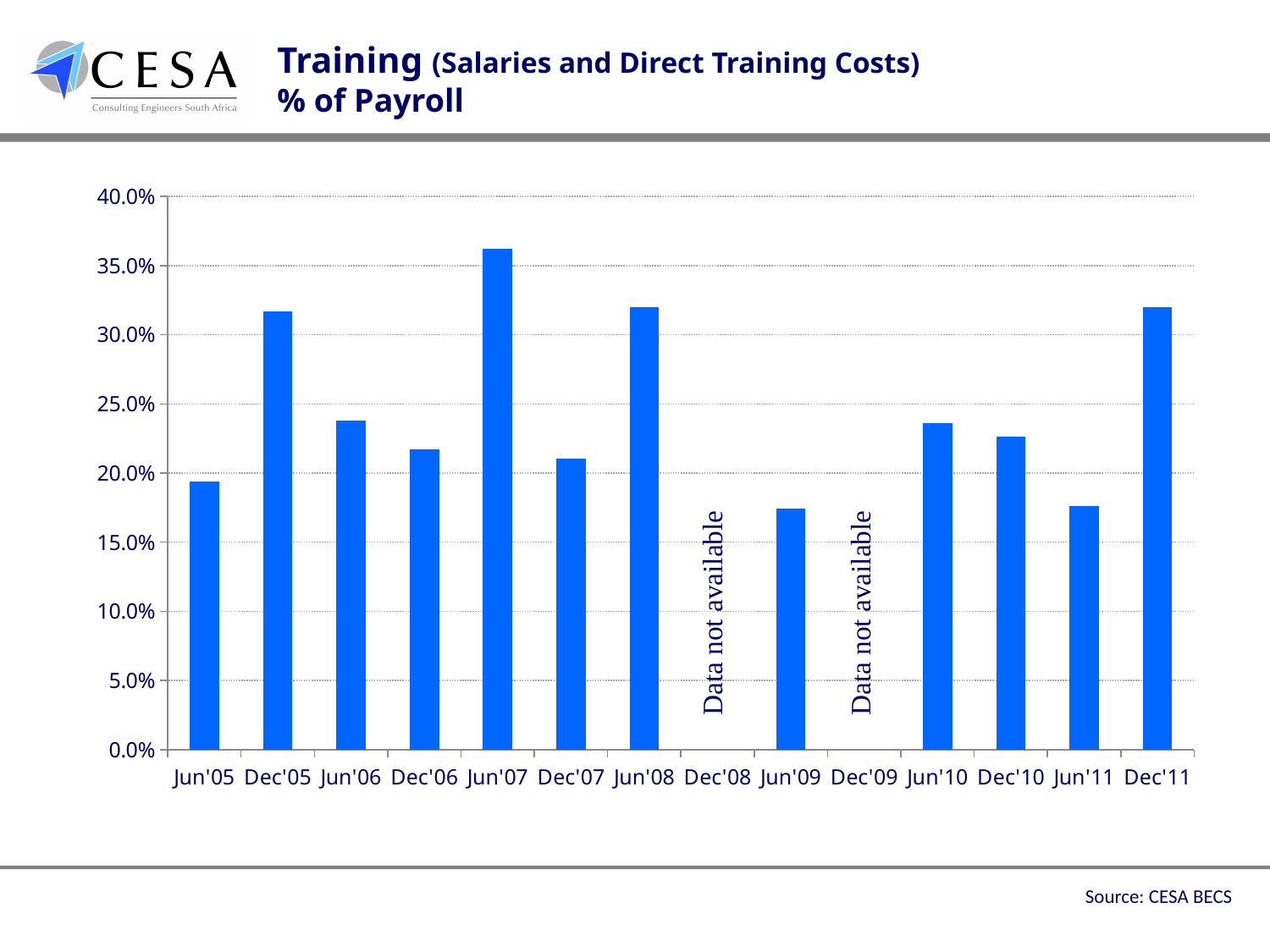
Which period has the highest training cost as a % of payroll? Jun'07 Which is larger, the value for Dec'05 or the value for Jun'06? Dec'05 Is the value for Dec'10 greater or less than 20.0%? greater Which is larger, the value for Jun'11 or the value for Dec'11? Dec'11 What kind of chart is shown on the slide? bar chart Which periods are marked as 'Data not available'? Dec'08 and Dec'09 How many periods are labelled on the x axis? 14 Is the value for Jun'06 greater or less than 25.0%? less Is the value for Dec'05 greater or less than 30.0%? greater